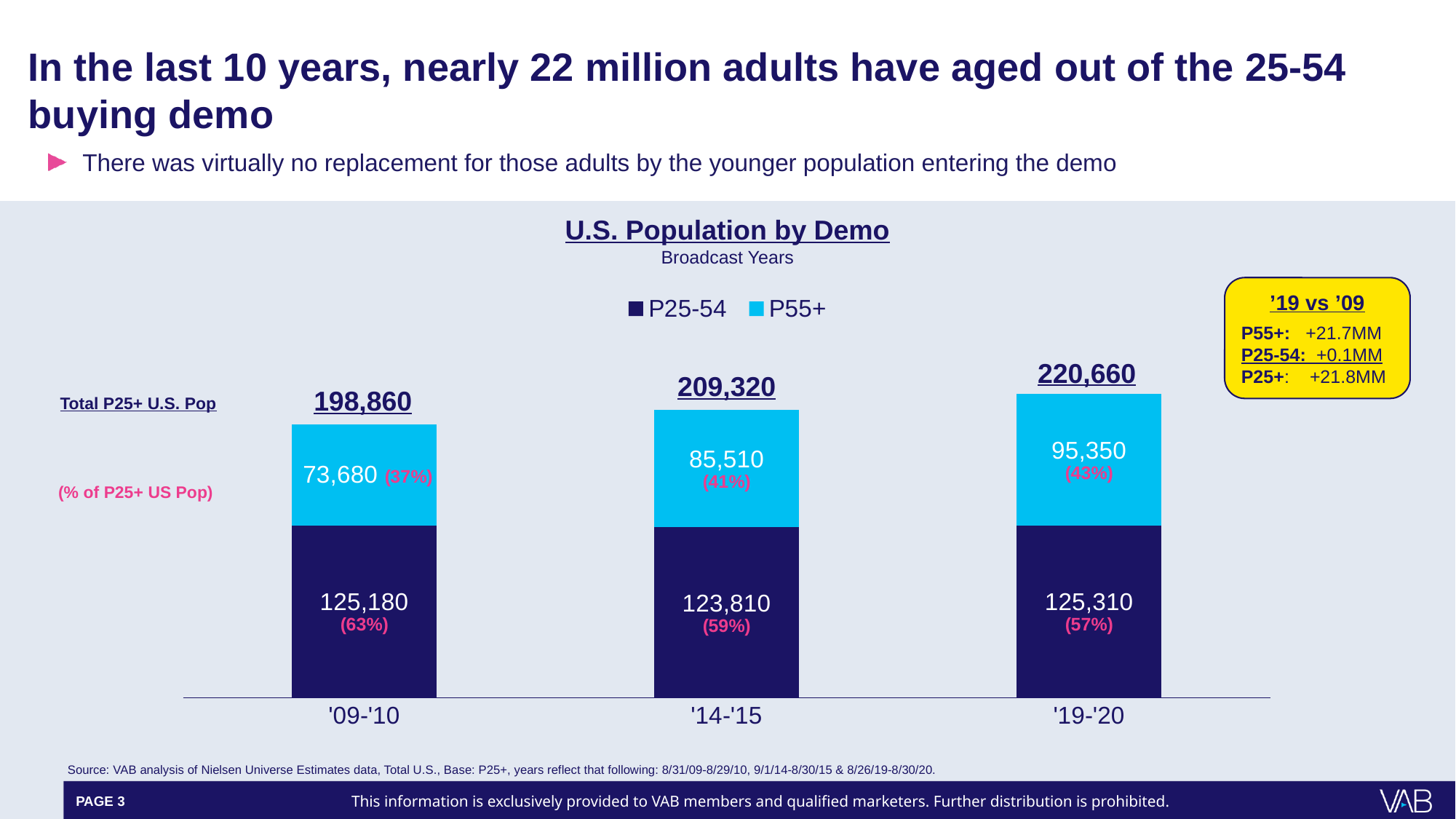
How many broadcast years are shown on the x axis? 3 What is the P25-54 value for '09-'10? 125,180 What is the total P25+ U.S. population shown for '14-'15? 209,320 Which broadcast year has the lowest P25-54 value? '14-'15 What is the P55+ value for '19-'20? 95,350 How many series does the legend list? 2 What is the P55+ value for '14-'15? 85,510 Which broadcast year has the highest P55+ value? '19-'20 Do the total P25+ values rise or fall from '09-'10 to '19-'20? rise What kind of chart is shown? stacked bar chart What is the difference between the P55+ values for '19-'20 and '09-'10? 21,670 Is the P25-54 value for '19-'20 larger or smaller than the P25-54 value for '09-'10? larger